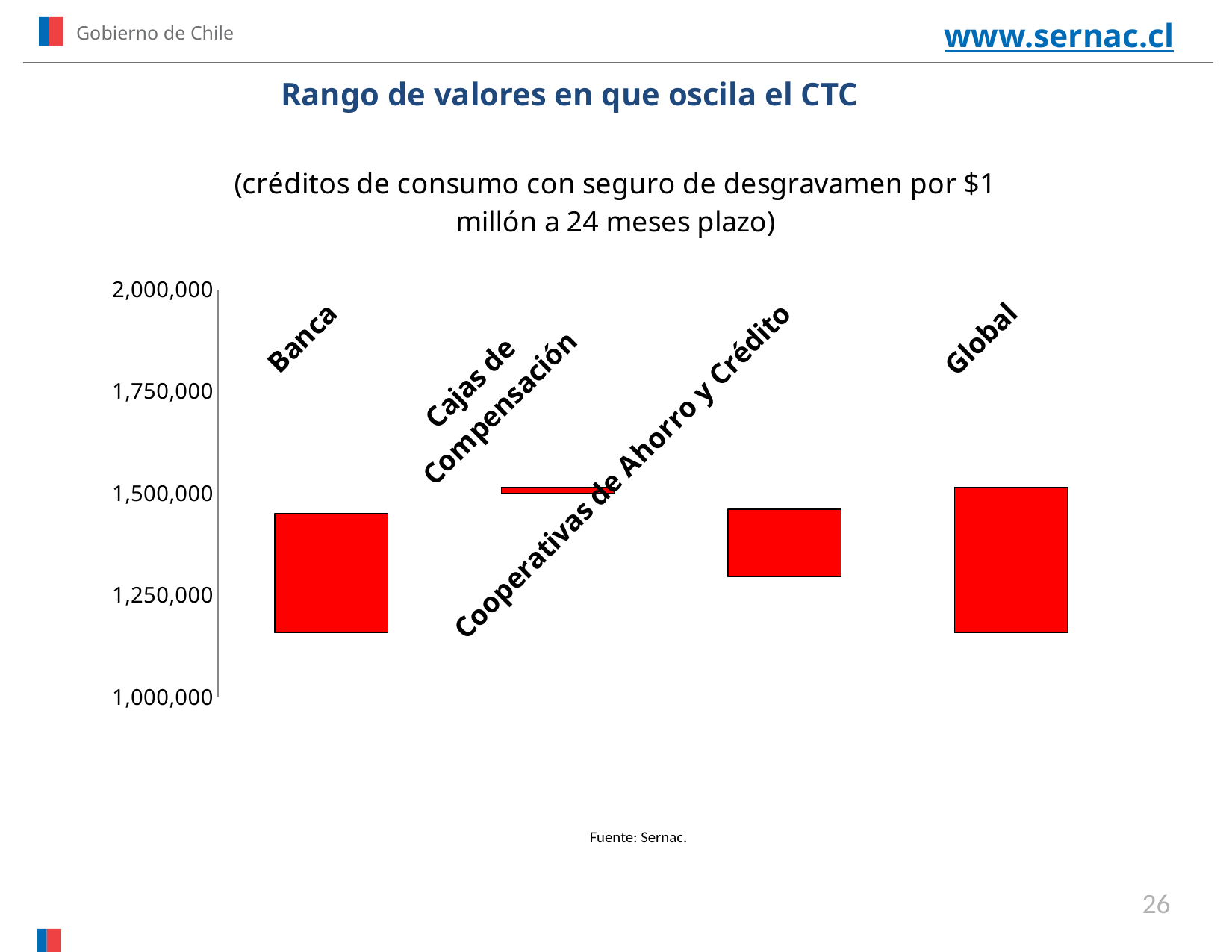
What kind of chart is shown on the slide? Bar chart Which category has the widest range of values? Global Which category has the highest lower bound of its range? Cajas de Compensación Is the bottom of the range for Global greater or less than 1,250,000? less What is the title of the chart? (créditos de consumo con seguro de desgravamen por $1 millón a 24 meses plazo) Is the top of the range for Banca greater or less than 1,500,000? less Is the bottom of the range for Banca greater or less than 1,250,000? less How many categories are shown on the chart? 4 Which category has the narrowest range of values? Cajas de Compensación Is the lower bound of the range for Cooperativas de Ahorro y Crédito higher or lower than that of Banca? higher